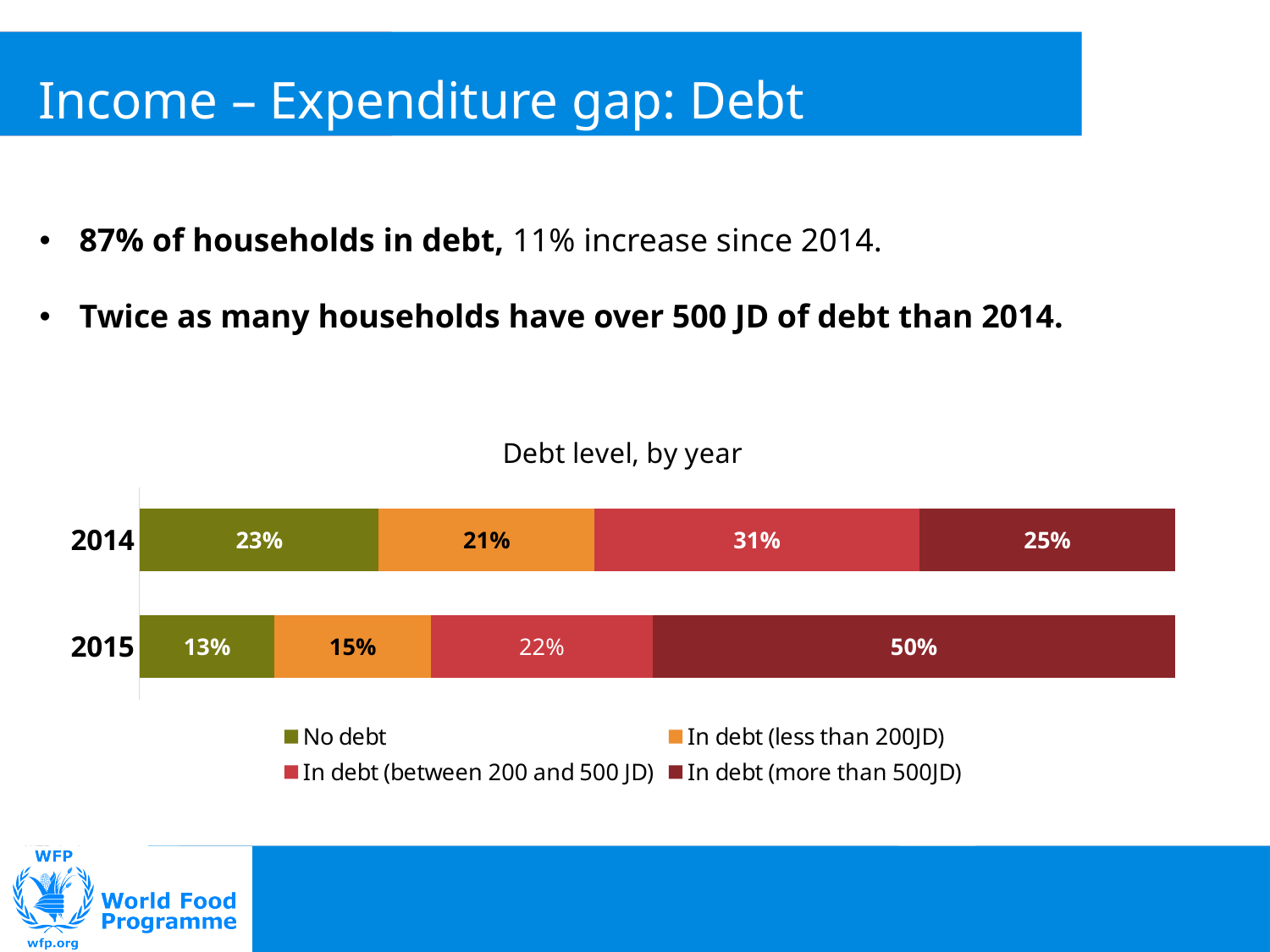
What is the value for "In debt (more than 500JD)" in 2015? 50% What is the value for "In debt (less than 200JD)" in 2014? 21% What is the title of the chart? Debt level, by year How many series does the legend list? 4 What is the difference between the "In debt (more than 500JD)" values for 2015 and 2014? 25% What kind of chart is shown on the slide? Stacked bar chart Which debt category has the largest share in 2015? In debt (more than 500JD) What is the value for "No debt" in 2014? 23% How many years are shown in the chart? 2 Which is larger: "No debt" in 2014 or "No debt" in 2015? 2014 Which debt category has the smallest share in 2015? No debt What is the value for "In debt (between 200 and 500 JD)" in 2015? 22%